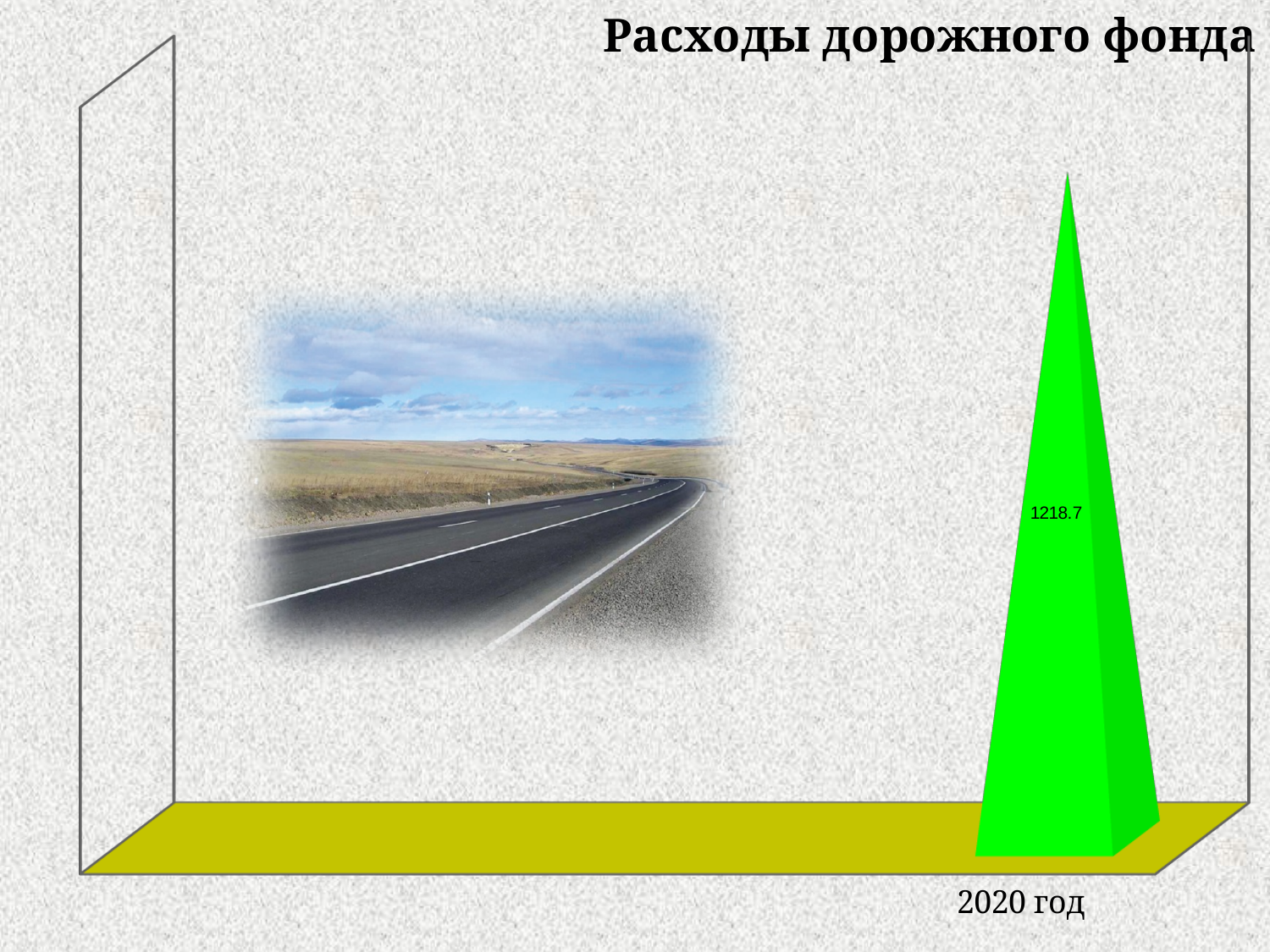
Which category label appears on the x axis of the chart? 2020 год What kind of chart is shown on the slide? bar chart How many categories are plotted on the chart? 1 What is the title of the chart? Расходы дорожного фонда What is the value shown for 2020 год? 1218.7 What colour is the bar for 2020 год? green